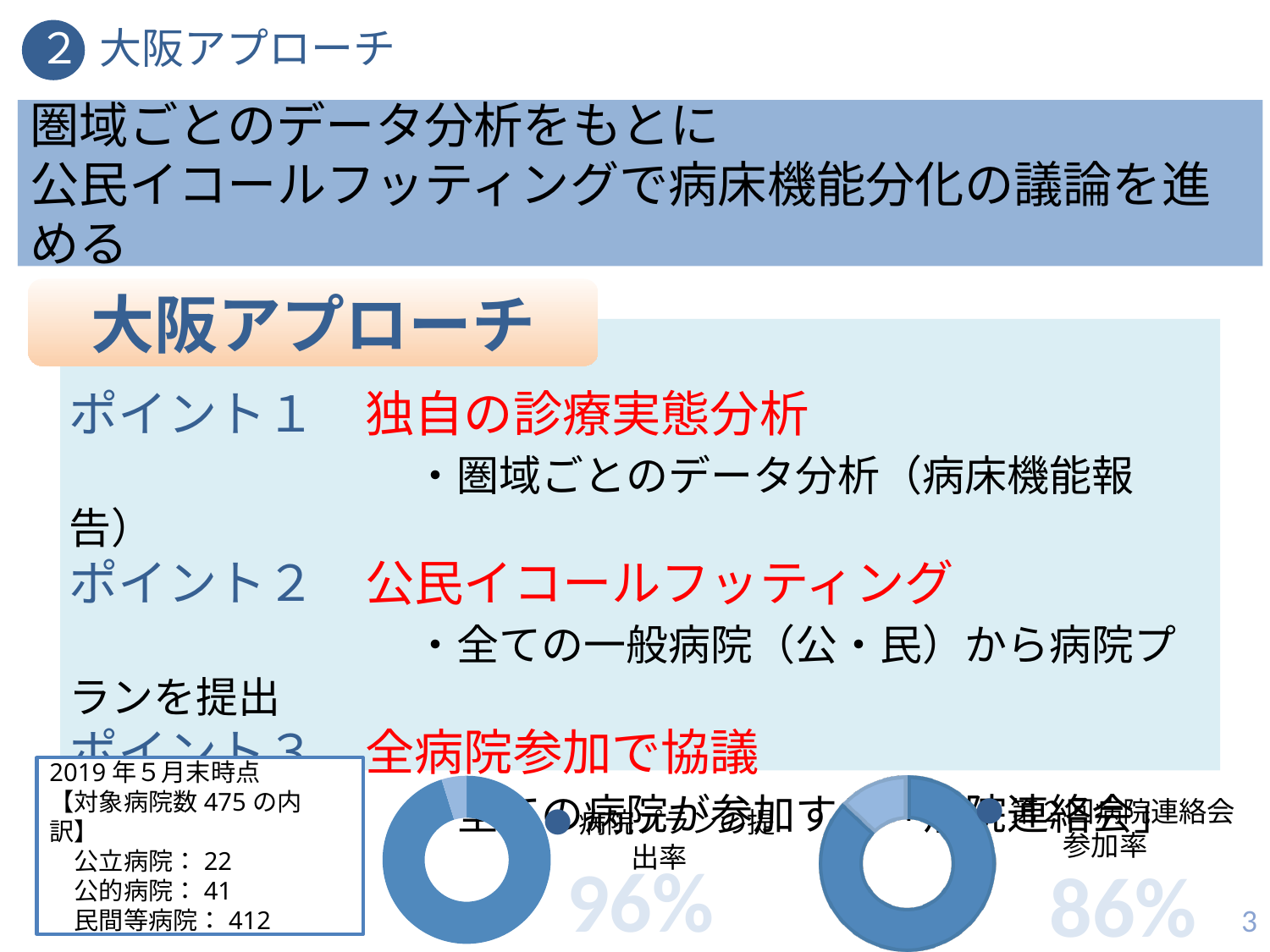
In the right chart (病院連絡会参加率), what percentage is shown? 86% What kind of chart is the left chart at the bottom of the slide (病院プランの提出率)? doughnut chart In the left chart (病院プランの提出率), what percentage is shown? 96% What is the difference between the 病院プランの提出率 (left chart) and the 病院連絡会参加率 (right chart)? 10% What is the title of the right doughnut chart? 病院連絡会参加率 How many doughnut charts are shown on the slide? 2 In the right chart (病院連絡会参加率), which colour fills the larger portion of the ring, dark blue or light blue? dark blue Which is larger, the 病院プランの提出率 shown in the left chart or the 病院連絡会参加率 shown in the right chart? 病院プランの提出率 In the right chart (病院連絡会参加率), is the value greater or less than 90%? less In the left chart (病院プランの提出率), is the value greater or less than 90%? greater What kind of chart is the right chart at the bottom of the slide (病院連絡会参加率)? doughnut chart